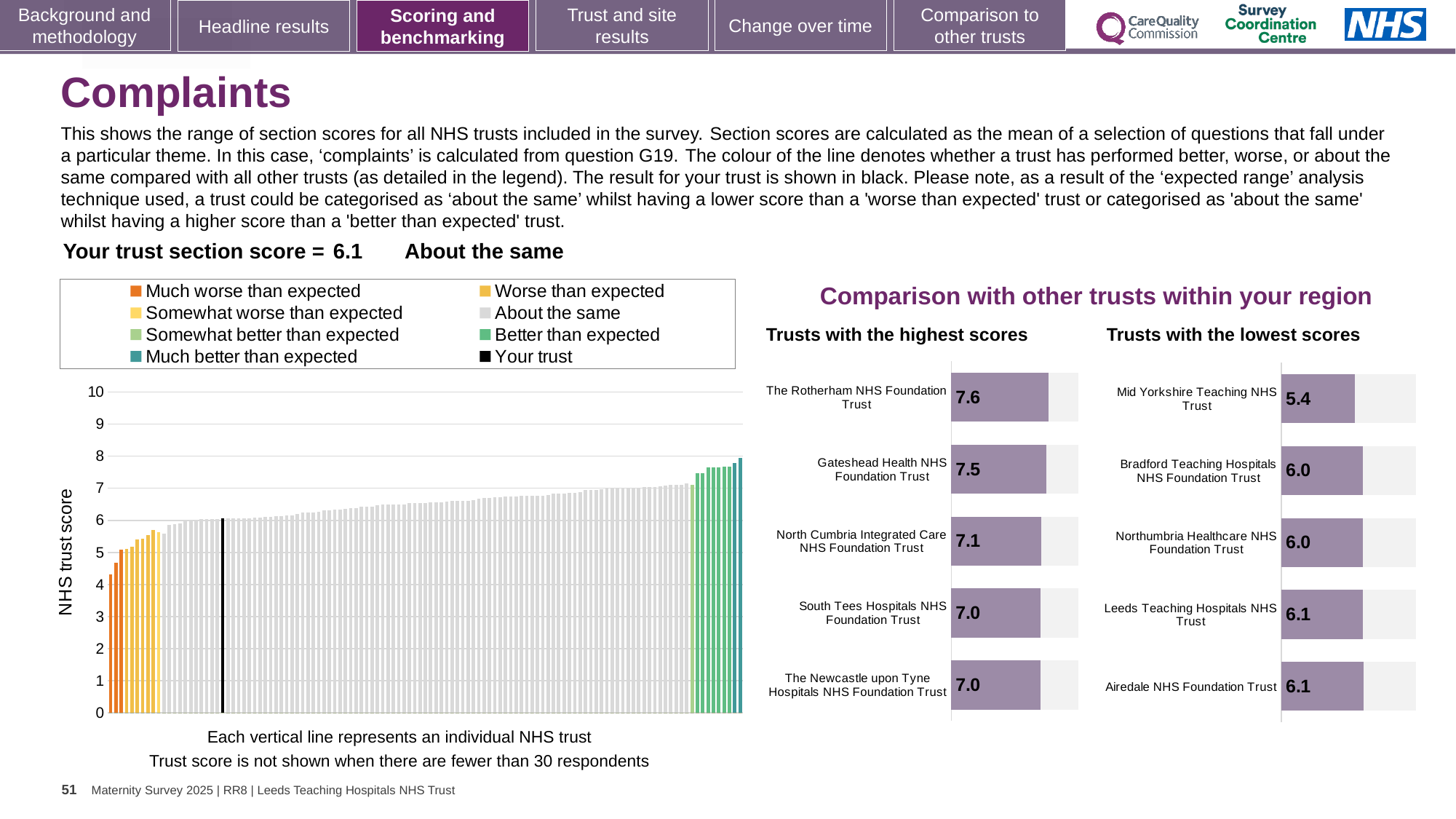
In the 'Trusts with the highest scores' chart, what is the difference between the scores of The Rotherham NHS Foundation Trust and The Newcastle upon Tyne Hospitals NHS Foundation Trust? 0.6 In the 'Trusts with the lowest scores' chart, what is the score for Mid Yorkshire Teaching NHS Trust? 5.4 In the 'Trusts with the lowest scores' chart, which trust has the lowest score? Mid Yorkshire Teaching NHS Trust How many trusts are shown in the 'Trusts with the highest scores' chart? 5 In the 'Trusts with the highest scores' chart, what is the score for The Rotherham NHS Foundation Trust? 7.6 In the 'Trusts with the highest scores' chart, which trust has the highest score? The Rotherham NHS Foundation Trust In the large chart on the left, is the value of the tallest bar greater or less than 7? greater How many entries does the legend of the large chart on the left list? 8 In the 'Trusts with the lowest scores' chart, which has the higher score: Bradford Teaching Hospitals NHS Foundation Trust or Leeds Teaching Hospitals NHS Trust? Leeds Teaching Hospitals NHS Trust What is your trust's section score shown on the slide for Complaints? 6.1 In the 'Trusts with the lowest scores' chart, what is the difference between the scores of Leeds Teaching Hospitals NHS Trust and Mid Yorkshire Teaching NHS Trust? 0.7 In the large chart on the left, do the bar values rise or fall from left to right? rise